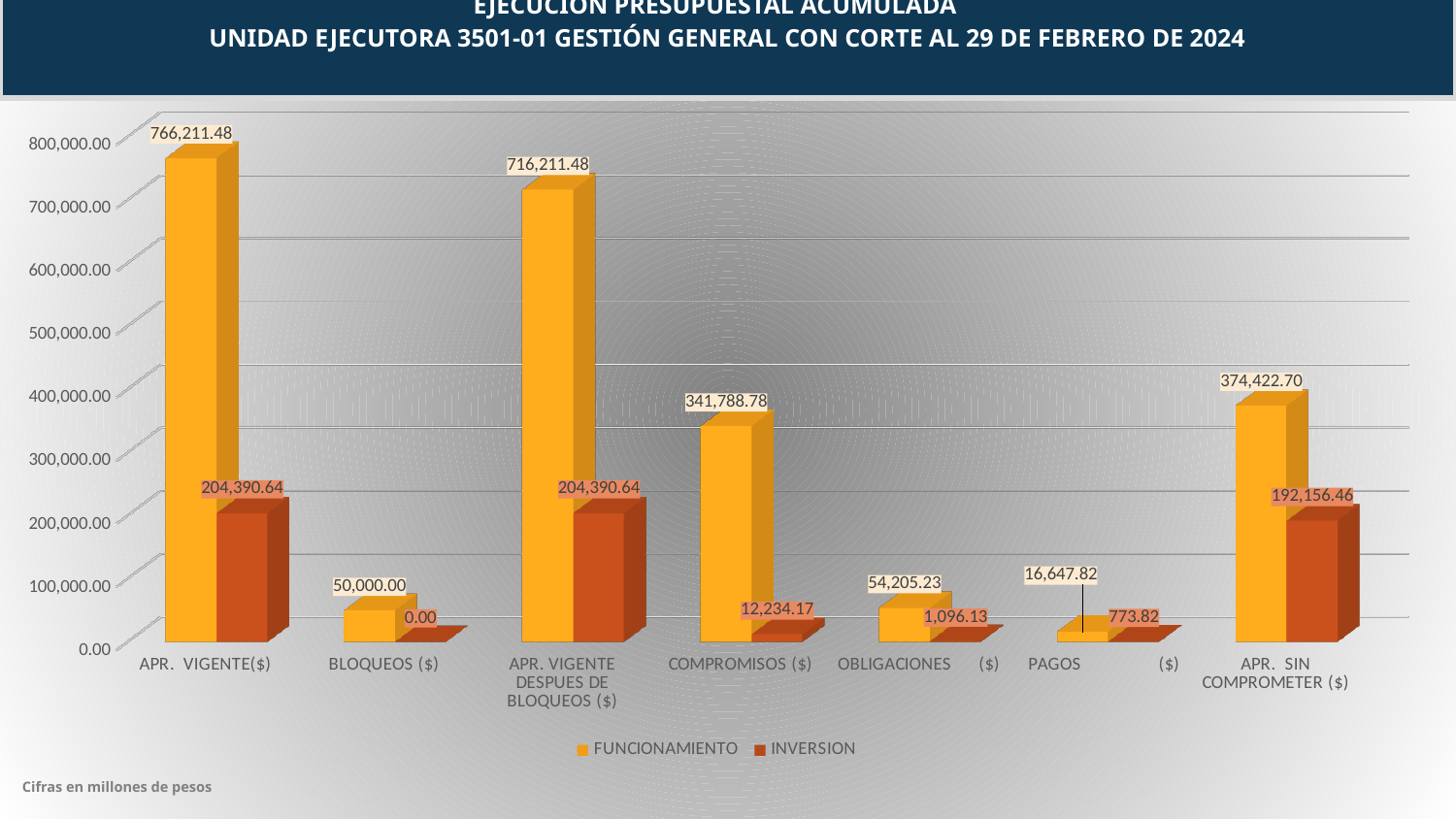
Which category has the highest FUNCIONAMIENTO value? APR. VIGENTE($) What is the difference between the FUNCIONAMIENTO and INVERSION values for APR. SIN COMPROMETER ($)? 182,266.24 What is the difference between the FUNCIONAMIENTO values for APR. VIGENTE($) and APR. VIGENTE DESPUES DE BLOQUEOS ($)? 50,000.00 What is the FUNCIONAMIENTO value for PAGOS ($)? 16,647.82 Which is larger for OBLIGACIONES ($): the FUNCIONAMIENTO value or the INVERSION value? FUNCIONAMIENTO What is the FUNCIONAMIENTO value for APR. VIGENTE($)? 766,211.48 Which category has the lowest INVERSION value? BLOQUEOS ($) What is the INVERSION value for BLOQUEOS ($)? 0.00 How many series does the legend list? 2 How many categories are shown on the x axis? 7 What is the INVERSION value for COMPROMISOS ($)? 12,234.17 What kind of chart is shown on the slide? Bar chart